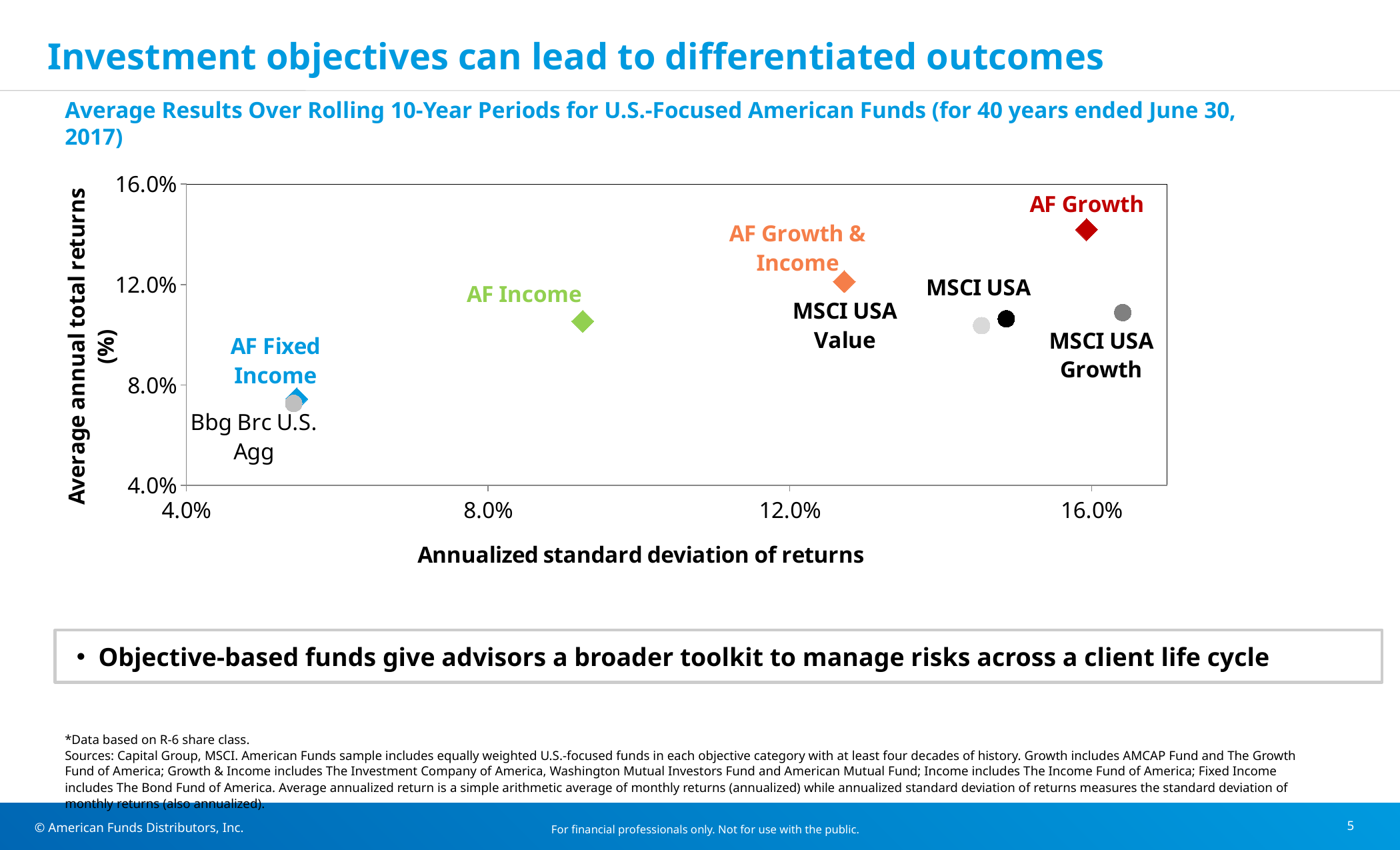
What kind of chart is shown on the slide? Scatter chart Is the annualized standard deviation of returns for MSCI USA Growth greater or less than 16.0%? greater Is the average annual total return for AF Growth greater or less than 12.0%? greater Which data point has the highest average annual total return? AF Growth Is the annualized standard deviation of returns for AF Income greater or less than 8.0%? greater Which has the higher average annual total return, AF Growth or MSCI USA Growth? AF Growth What is the title of the chart's x axis? Annualized standard deviation of returns Which has the higher average annual total return, AF Growth & Income or MSCI USA Value? AF Growth & Income What is the title of the chart's y axis? Average annual total returns (%) How many labeled data points are plotted on the chart? 8